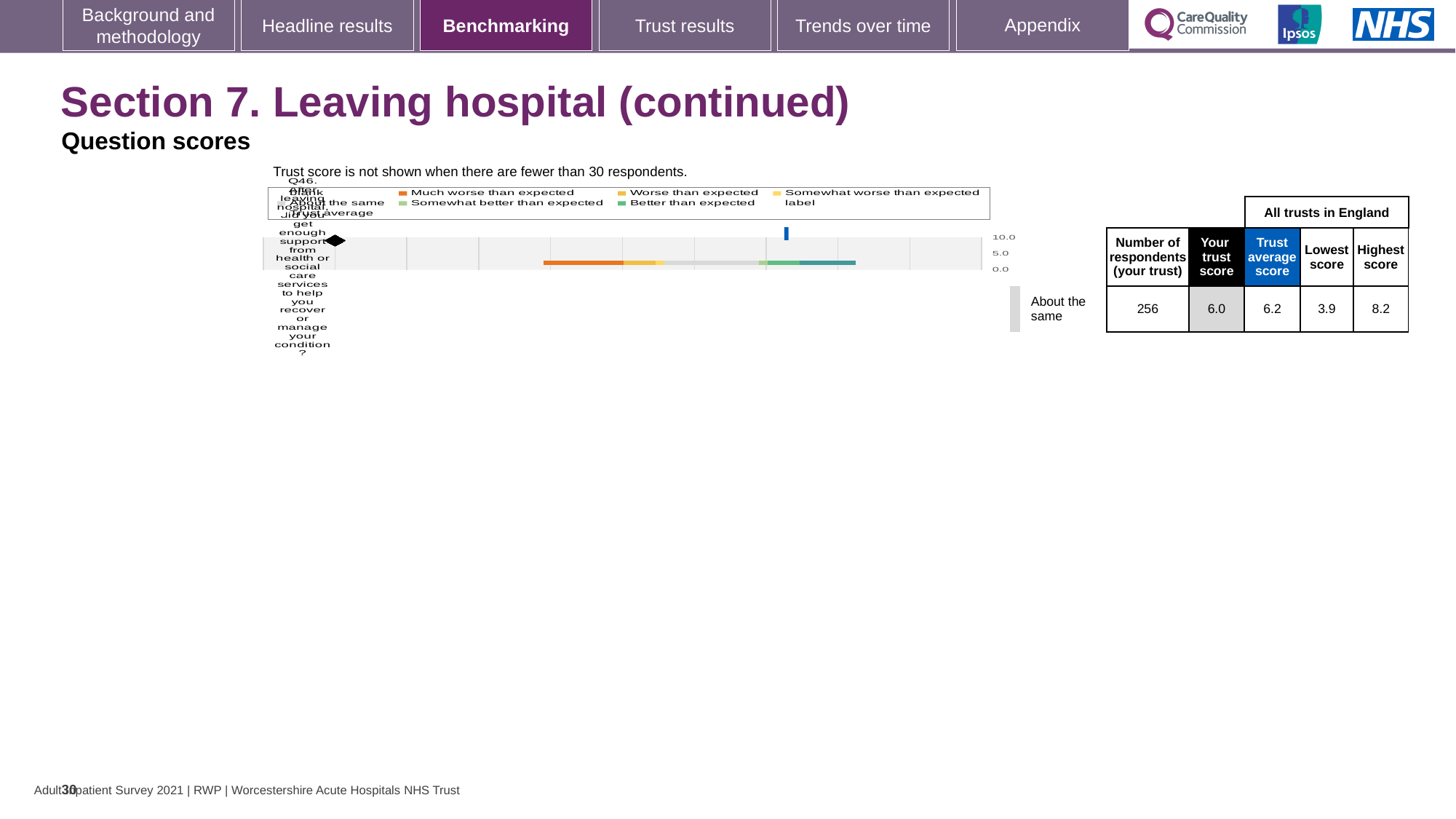
What is the trust score for Q46 shown on the slide? 6.0 Which is larger for Q46: the trust's own score or the trust average score? Trust average score By how much does the trust average score exceed the trust's own score for Q46? 0.2 Is the trust score for Q46 greater or less than 5.0 on the chart axis? greater How many questions are plotted on the chart? 1 Which benchmark category is the trust's Q46 score placed in? About the same What is the lowest score among all trusts in England for Q46? 3.9 How many respondents from the trust answered Q46? 256 What is the highest score among all trusts in England for Q46? 8.2 What is the difference between the highest score and the lowest score for Q46? 4.3 What is the trust average score for all trusts in England for Q46? 6.2 What kind of chart is used to show the Q46 benchmark? Bar chart